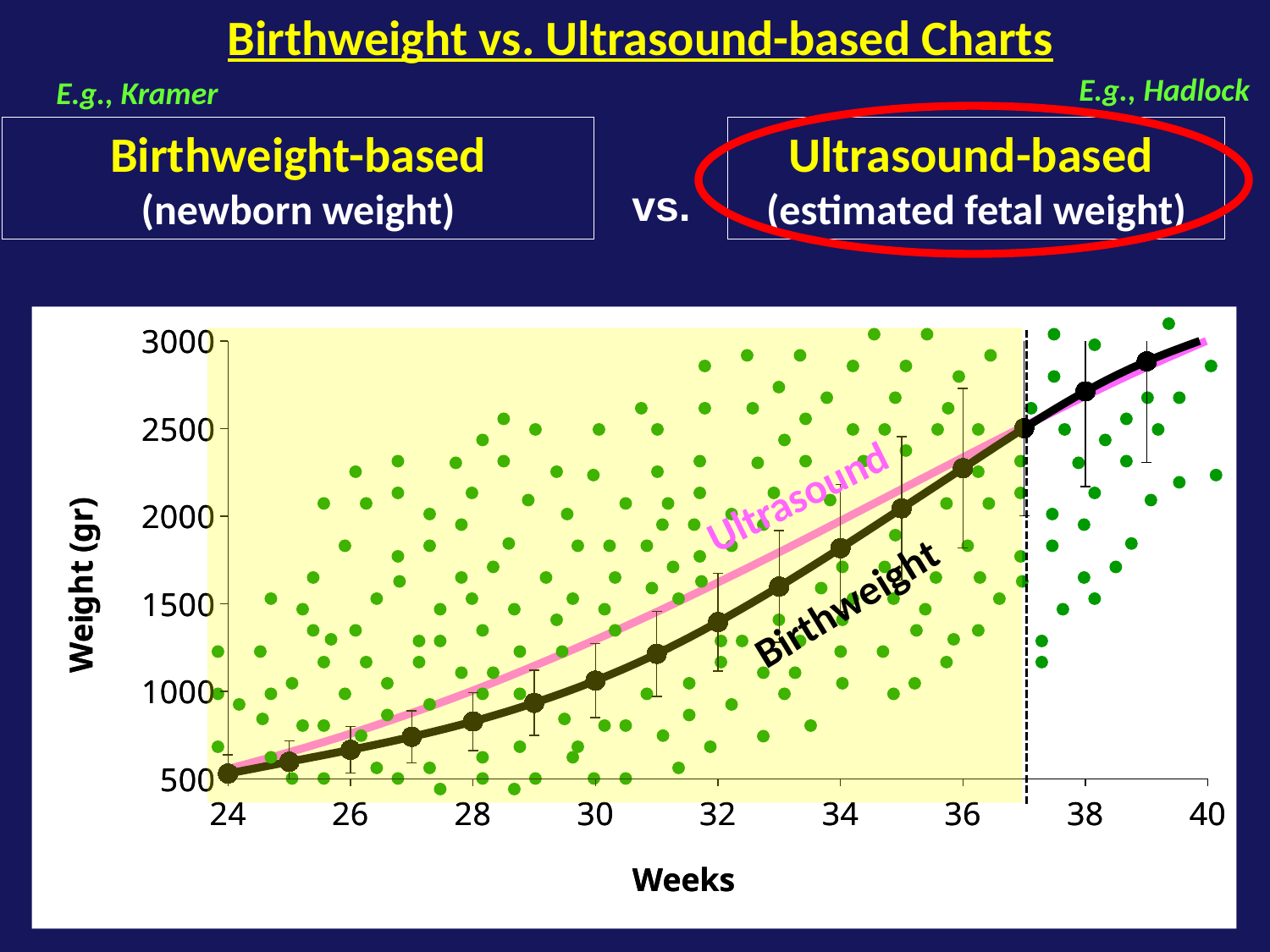
At 32 weeks, which curve is higher, Ultrasound or Birthweight? Ultrasound What kind of chart is shown on the slide? line chart Is the Birthweight value at 32 weeks greater or less than 1500? less Is the Birthweight value at 28 weeks greater or less than 1000? less Is the Birthweight value at 36 weeks greater or less than 2000? greater What is the label of the x axis of the chart? Weeks What is the label of the y axis of the chart? Weight (gr) At which week does the Birthweight curve reach its highest value? 40 How many tick labels are shown on the x axis of the chart? 9 Do the Birthweight values rise or fall as the weeks increase from 24 to 40? rise